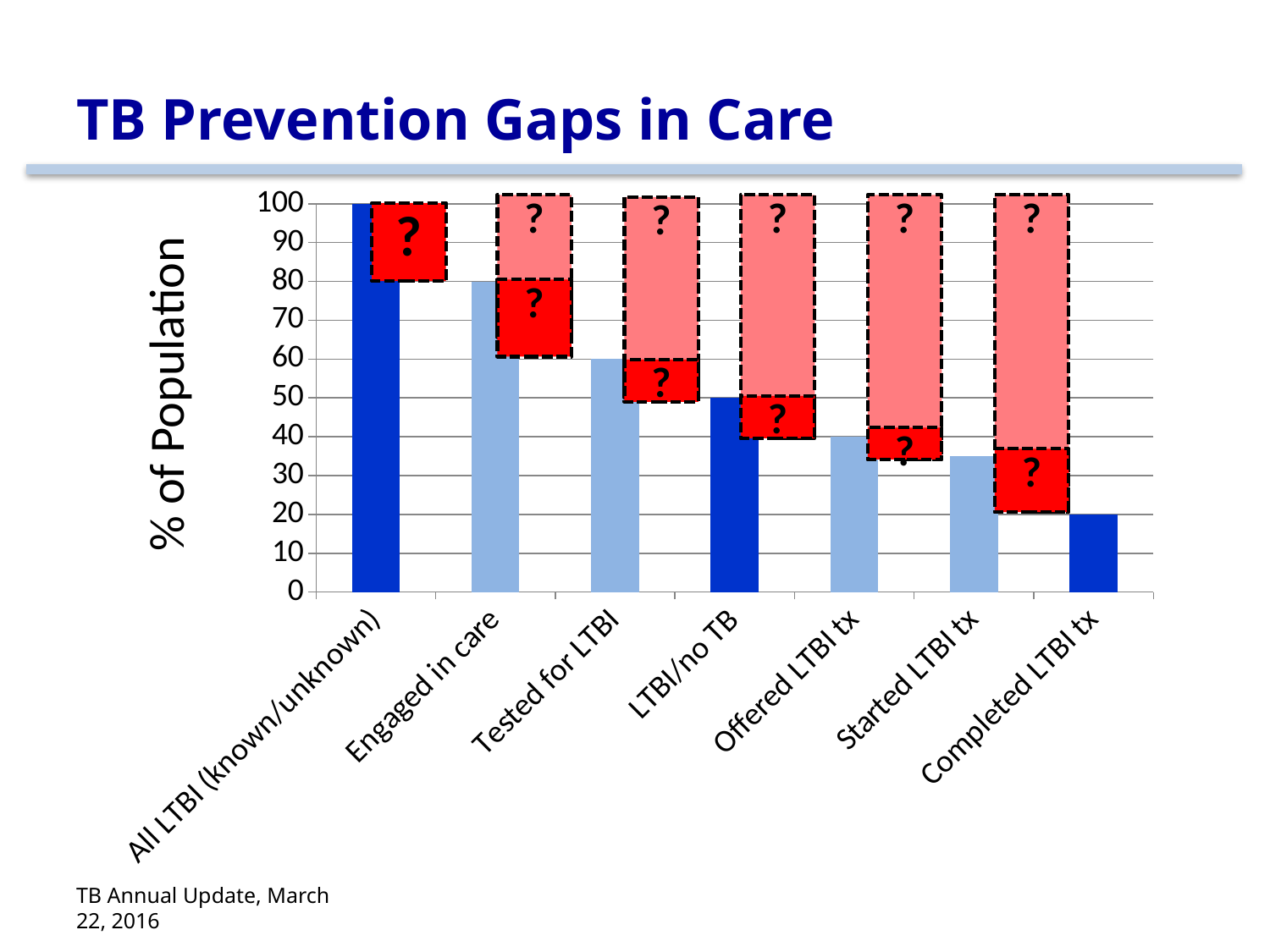
What is the value for Tested for LTBI? 60 What is the difference between the values for Engaged in care and Tested for LTBI? 20 What is the value for LTBI/no TB? 50 How many categories are shown on the x axis of the chart? 7 Which category has the highest value? All LTBI (known/unknown) What is the value for All LTBI (known/unknown)? 100 What is the value for Engaged in care? 80 Do the bar values rise or fall from left to right along the x axis? fall What is the value for Completed LTBI tx? 20 Which category has the lowest value? Completed LTBI tx What type of chart is shown on the slide? bar chart Is the value for Started LTBI tx greater or less than 40? less